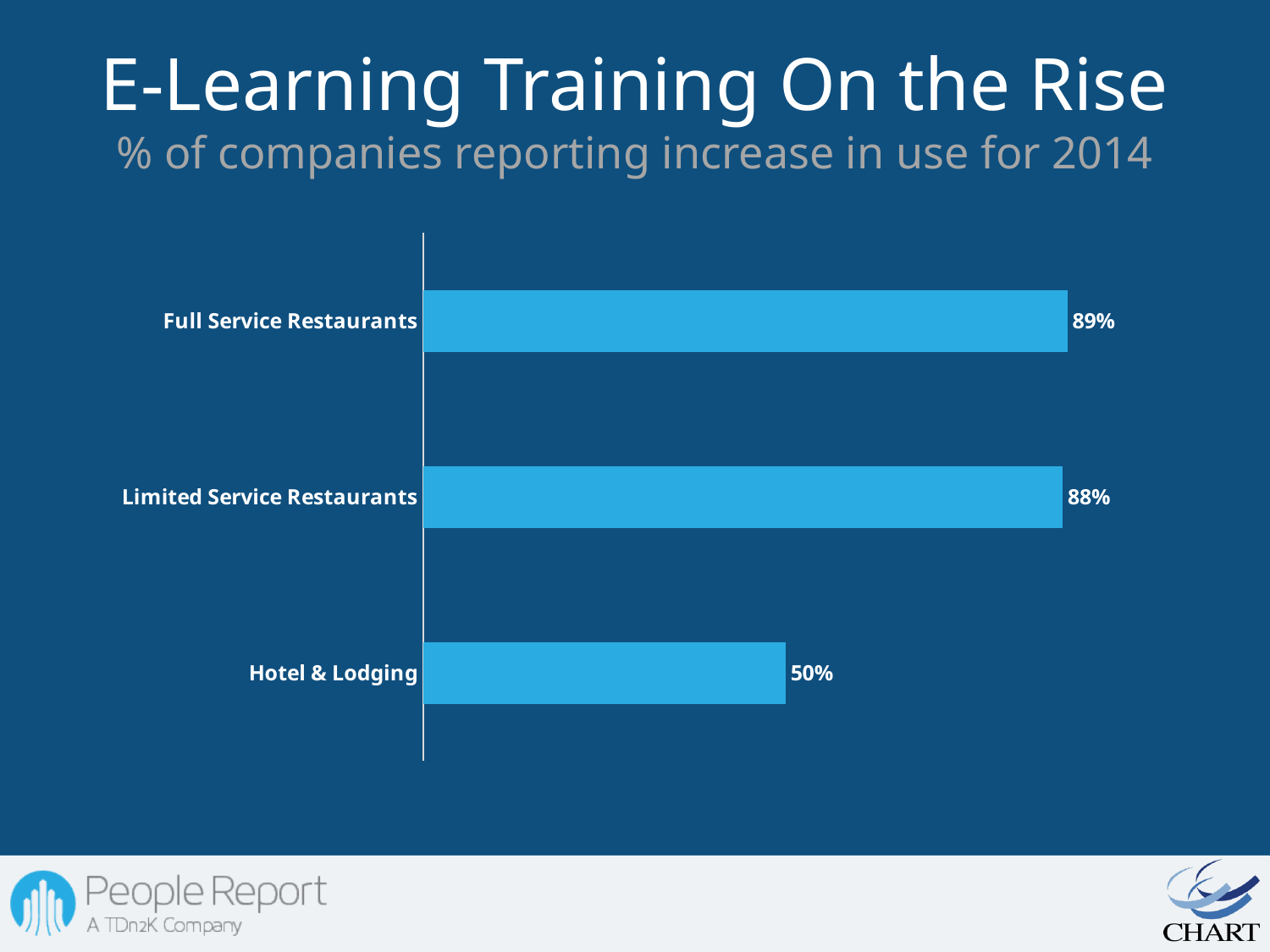
What is the difference between the values for Limited Service Restaurants and Hotel & Lodging? 38% What is the value shown for Limited Service Restaurants? 88% Which category has the highest value? Full Service Restaurants What does the subtitle say the chart measures? % of companies reporting increase in use for 2014 What is the value shown for Hotel & Lodging? 50% What percentage of Full Service Restaurants reported an increase in e-learning use for 2014? 89% What is the difference between the values for Full Service Restaurants and Hotel & Lodging? 39% What kind of chart is shown on the slide? Bar chart Which category has the lowest value? Hotel & Lodging Which is larger, the value for Limited Service Restaurants or the value for Hotel & Lodging? Limited Service Restaurants What is the title of the slide? E-Learning Training On the Rise How many categories are shown in the chart? 3